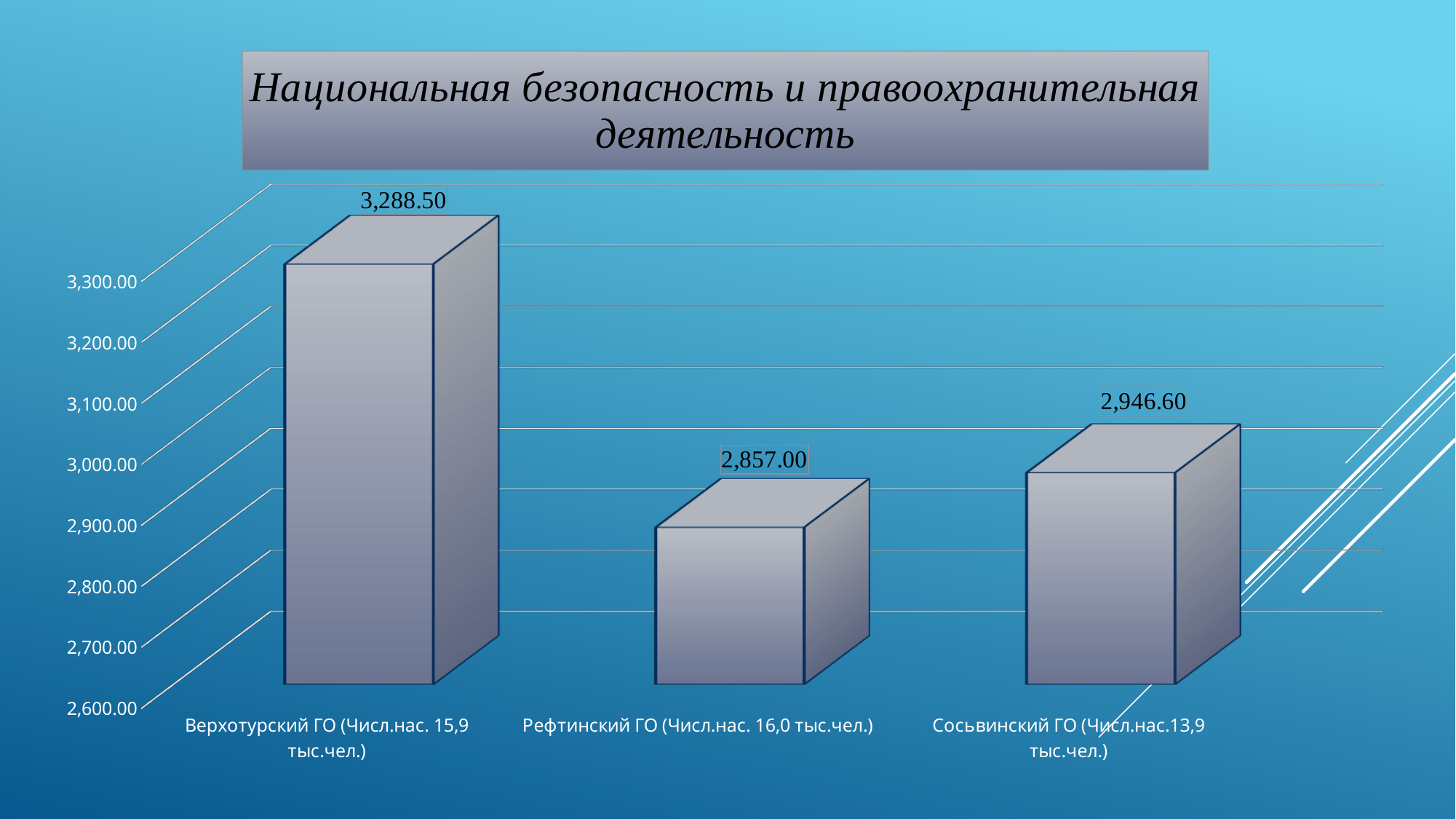
What is the value for Рефтинский ГО? 2,857.00 What is the difference between the values for Сосьвинский ГО and Рефтинский ГО? 89.60 Is the value for Рефтинский ГО greater or less than 2,900.00? less How many categories are shown in the chart? 3 Which category has the highest value? Верхотурский ГО What kind of chart is shown on the slide? bar chart What is the title of the chart? Национальная безопасность и правоохранительная деятельность What is the difference between the values for Верхотурский ГО and Рефтинский ГО? 431.50 What is the value for Сосьвинский ГО? 2,946.60 What is the value for Верхотурский ГО? 3,288.50 Which category has the lowest value? Рефтинский ГО Which is larger, the value for Сосьвинский ГО or the value for Рефтинский ГО? Сосьвинский ГО